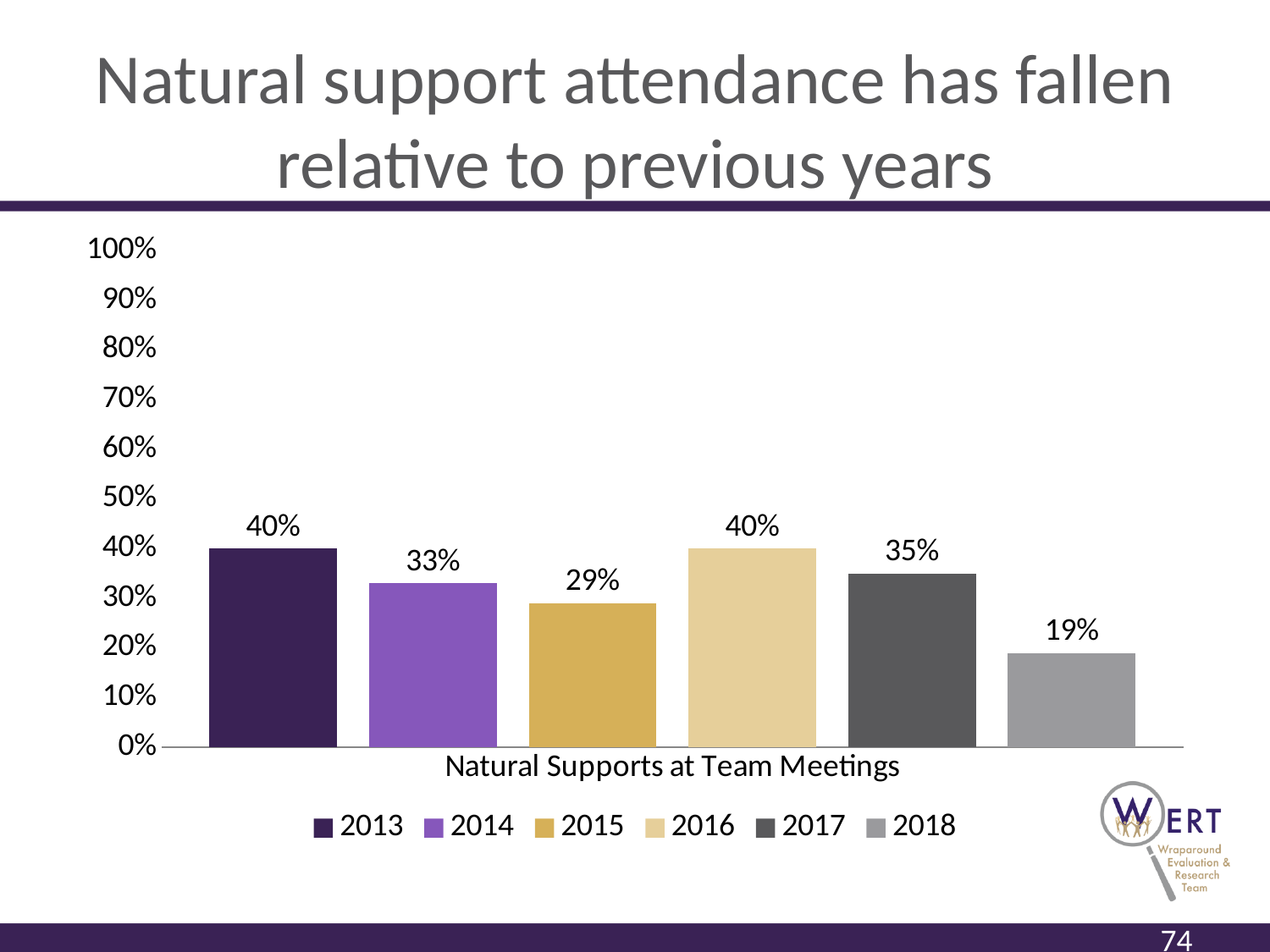
What kind of chart is shown on the slide? bar chart What is the difference between the values for 2017 and 2018? 16% What is the value for 2013? 40% What is the value for 2017? 35% What is the value for 2018? 19% What is the value for 2015? 29% What is the label on the x axis of the chart? Natural Supports at Team Meetings Which is larger, the value for 2016 or the value for 2017? 2016 How many series does the legend list? 6 Is the value for 2018 greater or less than 20%? less What is the difference between the values for 2014 and 2015? 4% Which year has the lowest value? 2018